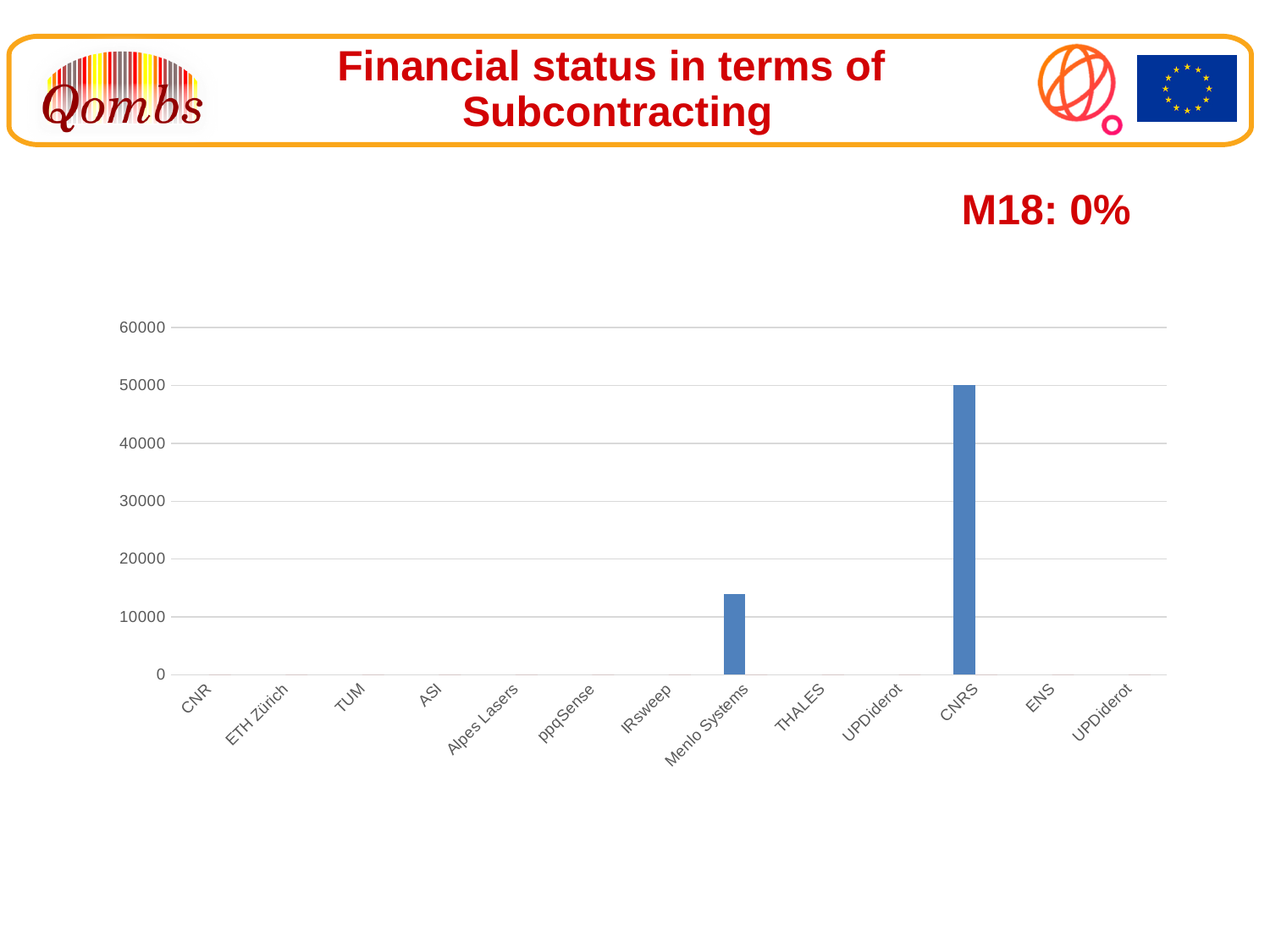
Is the value for CNRS greater or less than 40000? greater What is the highest value shown on the y axis of the chart? 60000 What is the value for CNRS in the chart? 50000 How many categories in the chart have a visible bar above zero? 2 Which is larger, the value for CNRS or the value for Menlo Systems? CNRS What percentage is stated next to M18 on the slide? 0% Which category has the highest value in the chart? CNRS Which is larger, the value for Menlo Systems or the value for THALES? Menlo Systems What kind of chart is shown on the slide? bar chart Is the value for Menlo Systems greater or less than 20000? less How many categories are shown along the x axis of the chart? 13 Is the value for Menlo Systems greater or less than 10000? greater